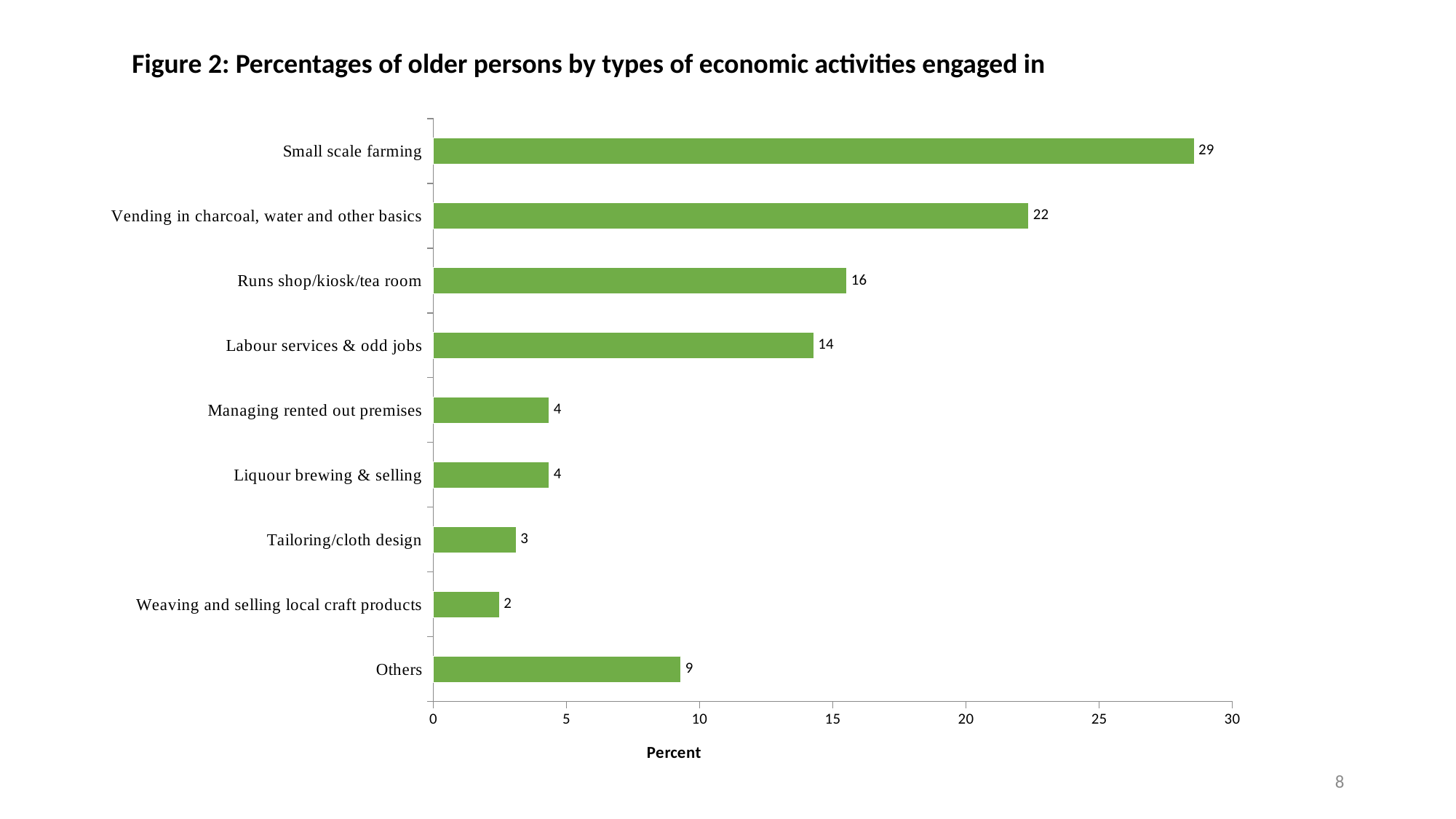
What is the label of the horizontal axis? Percent What is the value for Vending in charcoal, water and other basics? 22 What percentage of older persons are engaged in small scale farming? 29 Which is larger, the value for Tailoring/cloth design or the value for Others? Others What kind of chart is shown on the slide? Bar chart Which economic activity has the lowest percentage? Weaving and selling local craft products What is the value for Labour services & odd jobs? 14 Is the value for Vending in charcoal, water and other basics greater or less than 20? greater Which economic activity has the highest percentage? Small scale farming How many economic activity categories are shown in the chart? 9 What is the value for Others? 9 What is the difference between the values for Small scale farming and Runs shop/kiosk/tea room? 13